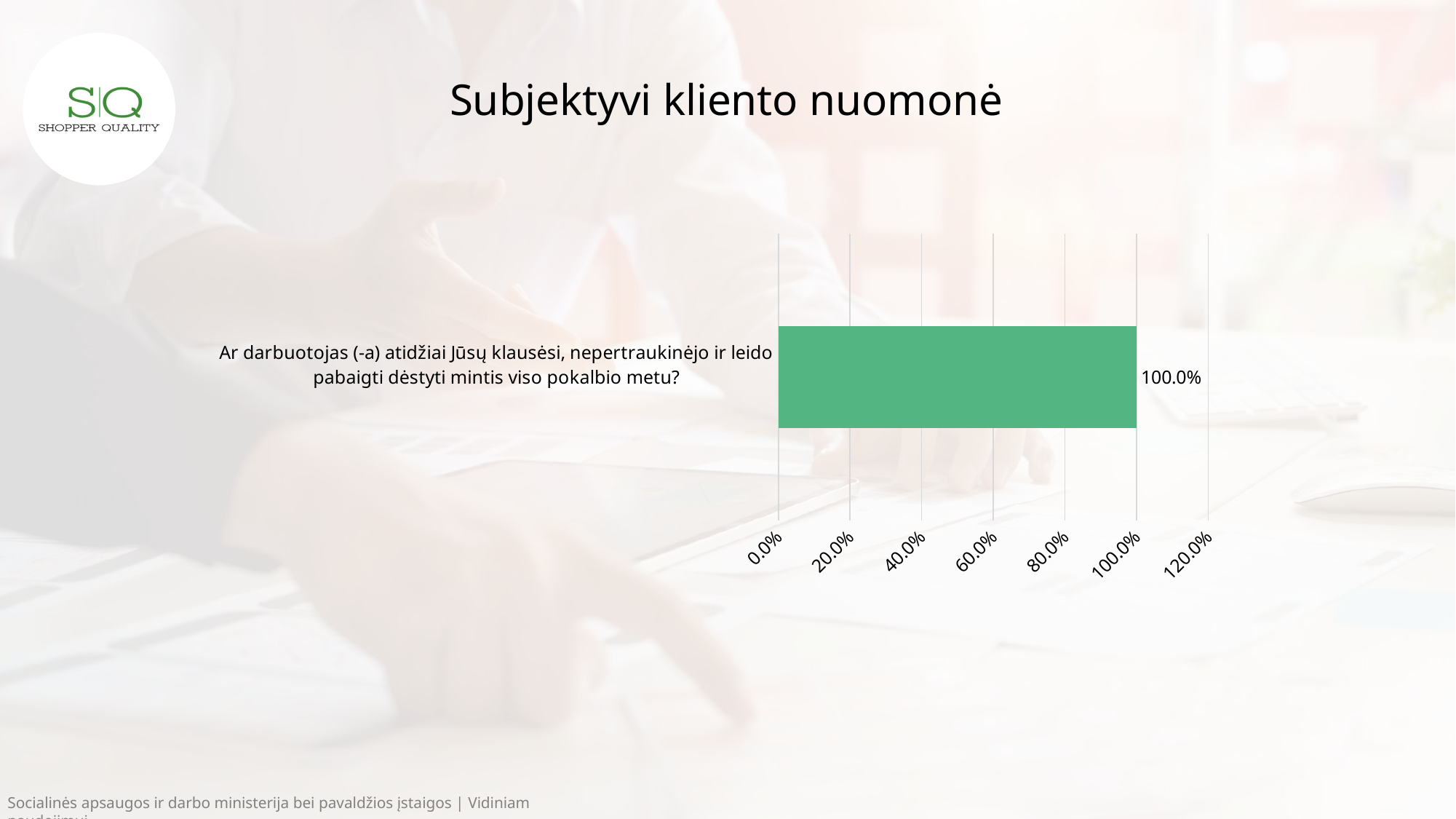
What is the highest value shown on the horizontal axis of the chart? 120.0% How many categories are plotted in the chart? 1 What is the value shown for the category "Ar darbuotojas (-a) atidžiai Jūsų klausėsi, nepertraukinėjo ir leido pabaigti dėstyti mintis viso pokalbio metu?"? 100.0% Are the bars in the chart horizontal or vertical? horizontal What is the title of the slide containing the chart? Subjektyvi kliento nuomonė Is the value for "Ar darbuotojas (-a) atidžiai Jūsų klausėsi, nepertraukinėjo ir leido pabaigti dėstyti mintis viso pokalbio metu?" greater or less than 120.0%? less Is the value for "Ar darbuotojas (-a) atidžiai Jūsų klausėsi, nepertraukinėjo ir leido pabaigti dėstyti mintis viso pokalbio metu?" greater or less than 80.0%? greater What kind of chart is shown on the slide? bar chart